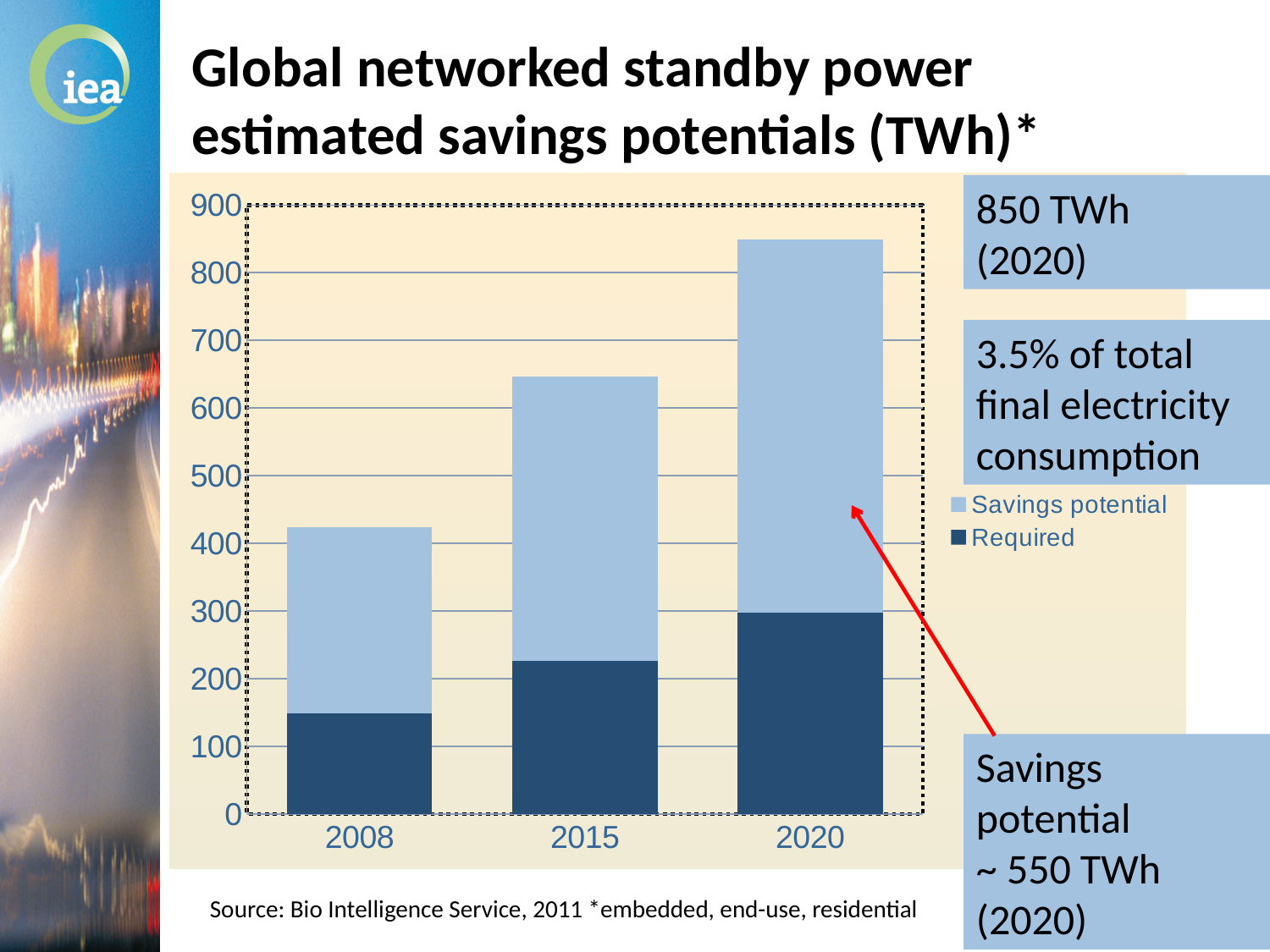
Which year has the tallest stacked bar? 2020 How many series does the chart's legend list? 2 How many years are shown on the x axis of the chart? 3 Is the Required value for 2008 greater or less than 200? less Is the total stacked value for 2008 greater or less than 400? greater What kind of chart is shown on the slide? stacked bar chart Do the total bar heights rise or fall from 2008 to 2020? rise Which year has the shortest stacked bar? 2008 Is the total stacked value for 2015 greater or less than 600? greater According to the annotation on the slide, what is the total networked standby power for 2020? 850 TWh Which year has the larger Required value, 2008 or 2020? 2020